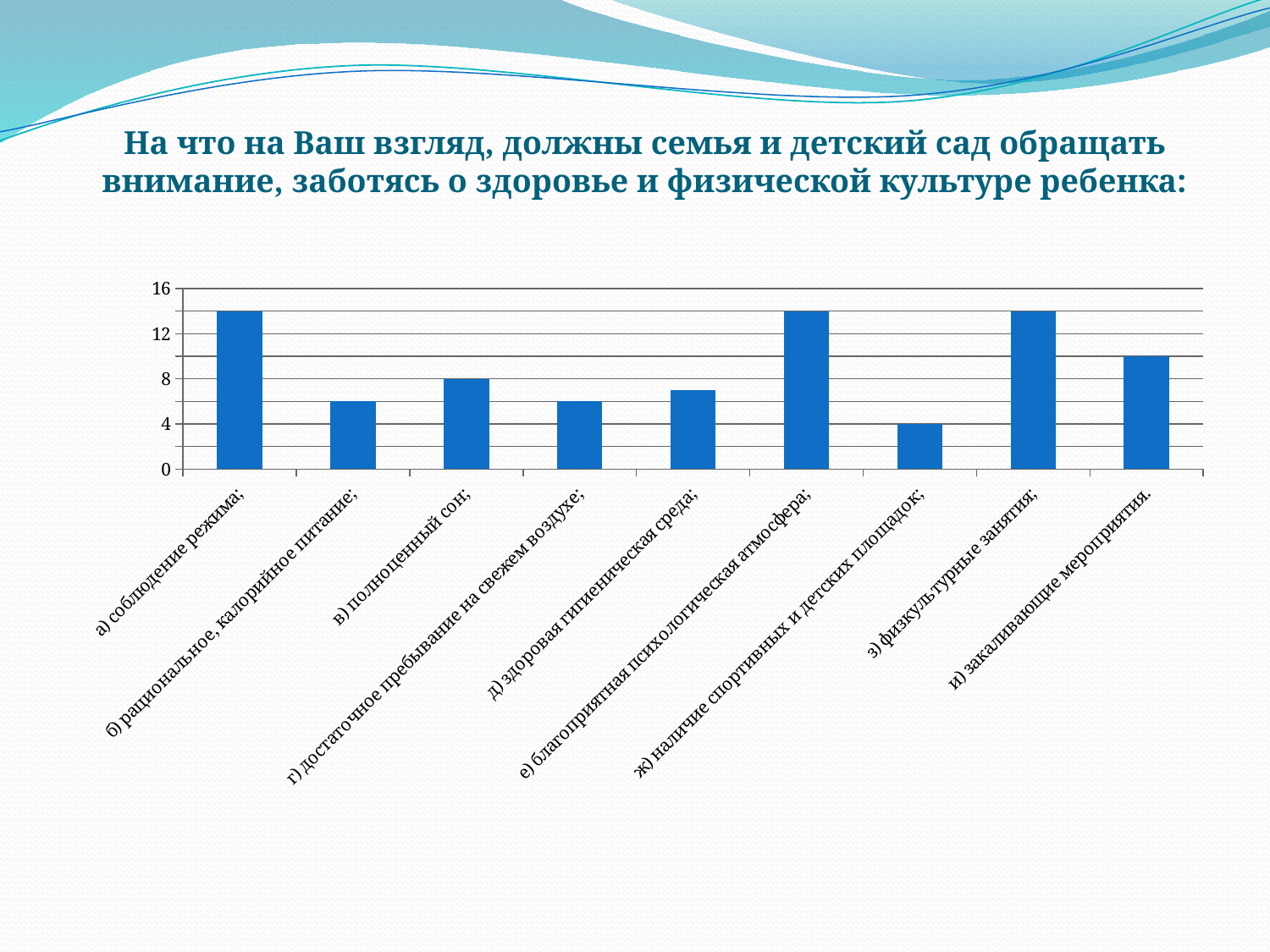
What kind of chart is shown on the slide? bar chart Which category has the lowest value? ж) наличие спортивных и детских площадок Is the value for "б) рациональное, калорийное питание" greater or less than 8? less Is the value for "д) здоровая гигиеническая среда" greater or less than 8? less Which is larger, the value for "е) благоприятная психологическая атмосфера" or the value for "и) закаливающие мероприятия"? е) благоприятная психологическая атмосфера What is the value for "ж) наличие спортивных и детских площадок"? 4 What is the value for "в) полноценный сон"? 8 How many categories are shown on the x axis of the chart? 9 Is the value for "а) соблюдение режима" greater or less than 12? greater What is the difference between the values for "в) полноценный сон" and "ж) наличие спортивных и детских площадок"? 4 What is the highest value labelled on the vertical axis of the chart? 16